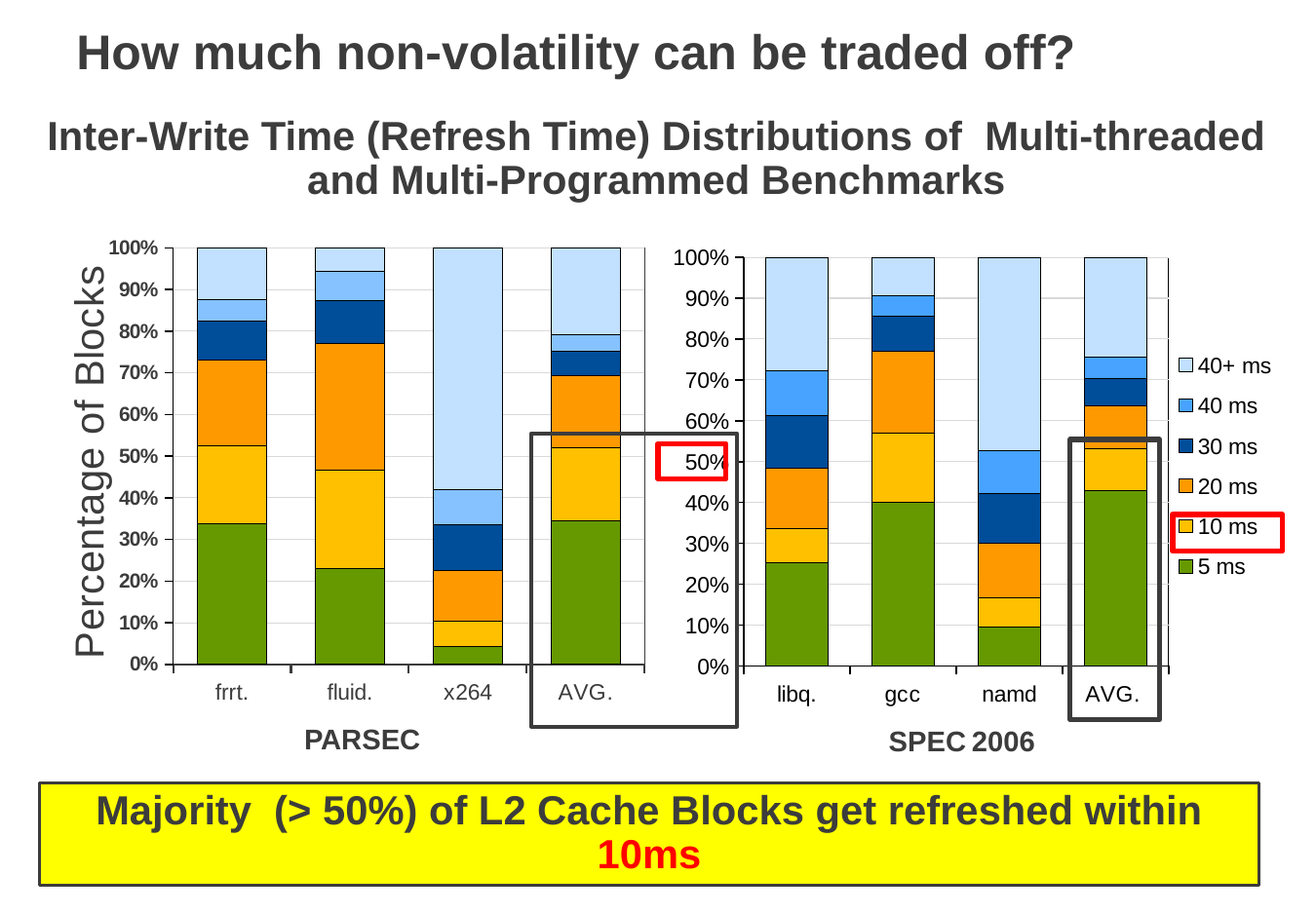
How many series does the legend list for the charts? 6 Which legend entry is highlighted with a red box? 10 ms In the PARSEC chart, is the 5 ms share for frrt. greater or less than 30%? greater In the SPEC 2006 chart, what is the total height of the stacked bar for libq.? 100% What kind of chart is the PARSEC chart on the left? stacked bar chart In the SPEC 2006 chart, is the 5 ms share for gcc greater or less than 30%? greater How many benchmark categories are shown on the x axis of the SPEC 2006 chart? 4 In the SPEC 2006 chart, which benchmark has the larger 5 ms segment, gcc or namd? gcc In the PARSEC chart, which benchmark has the largest 40+ ms segment? x264 In the PARSEC chart, which benchmark has the smallest 5 ms segment? x264 In the PARSEC chart, is the 5 ms share for x264 greater or less than 10%? less